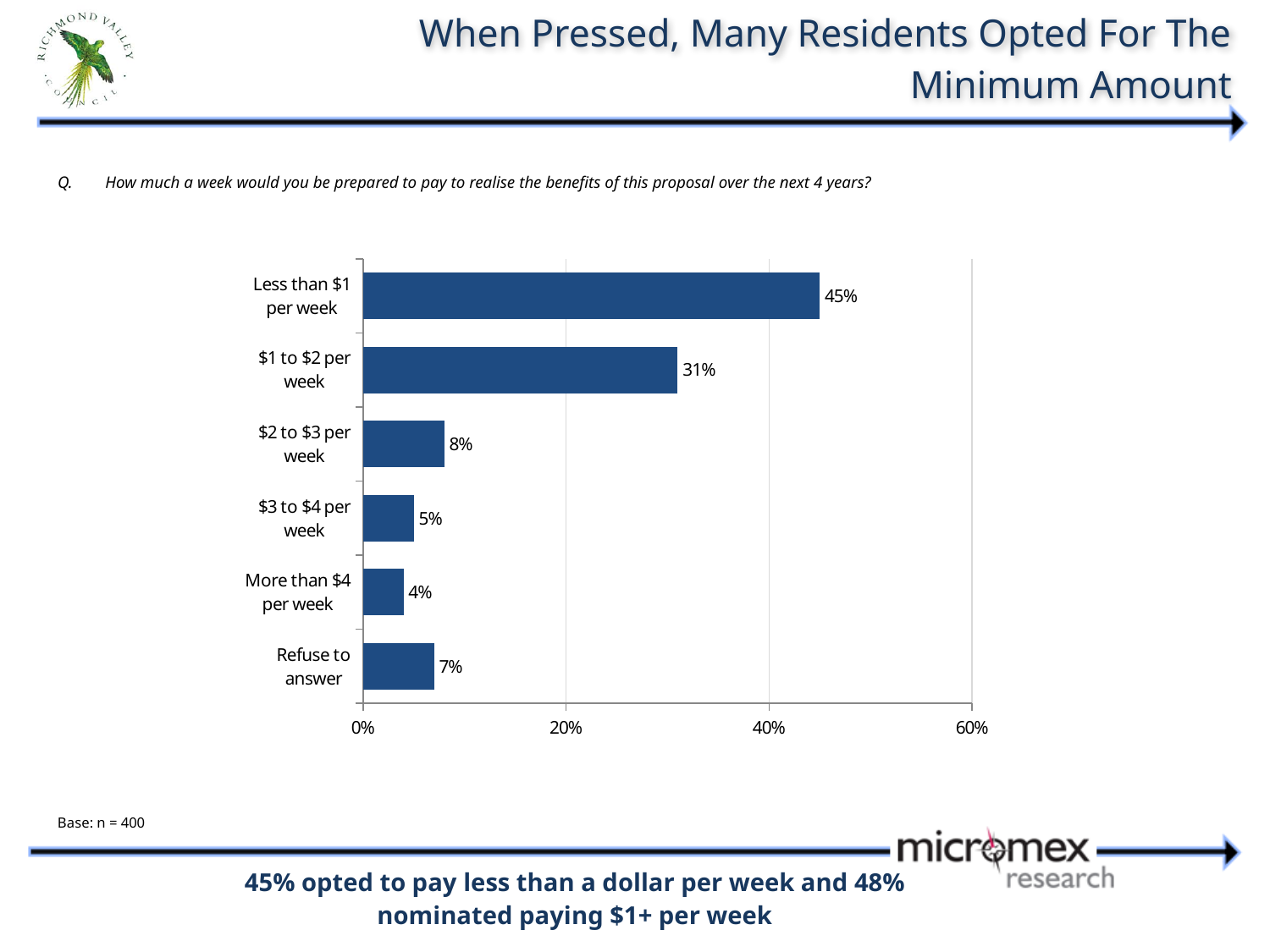
Which category has the lowest value? More than $4 per week Which category has the highest value? Less than $1 per week What percentage of residents said they would pay less than $1 per week? 45% Is the value for '$1 to $2 per week' greater or less than 20%? greater What is the base sample size stated on the slide? n = 400 What kind of chart is shown on the slide? Bar chart What is the value for '$1 to $2 per week'? 31% What is the difference between the values for 'Less than $1 per week' and '$1 to $2 per week'? 14 percentage points Which is larger: the value for '$2 to $3 per week' or the value for 'Refuse to answer'? $2 to $3 per week What percentage of residents refused to answer? 7% How many categories are shown in the chart? 6 What is the value for 'More than $4 per week'? 4%